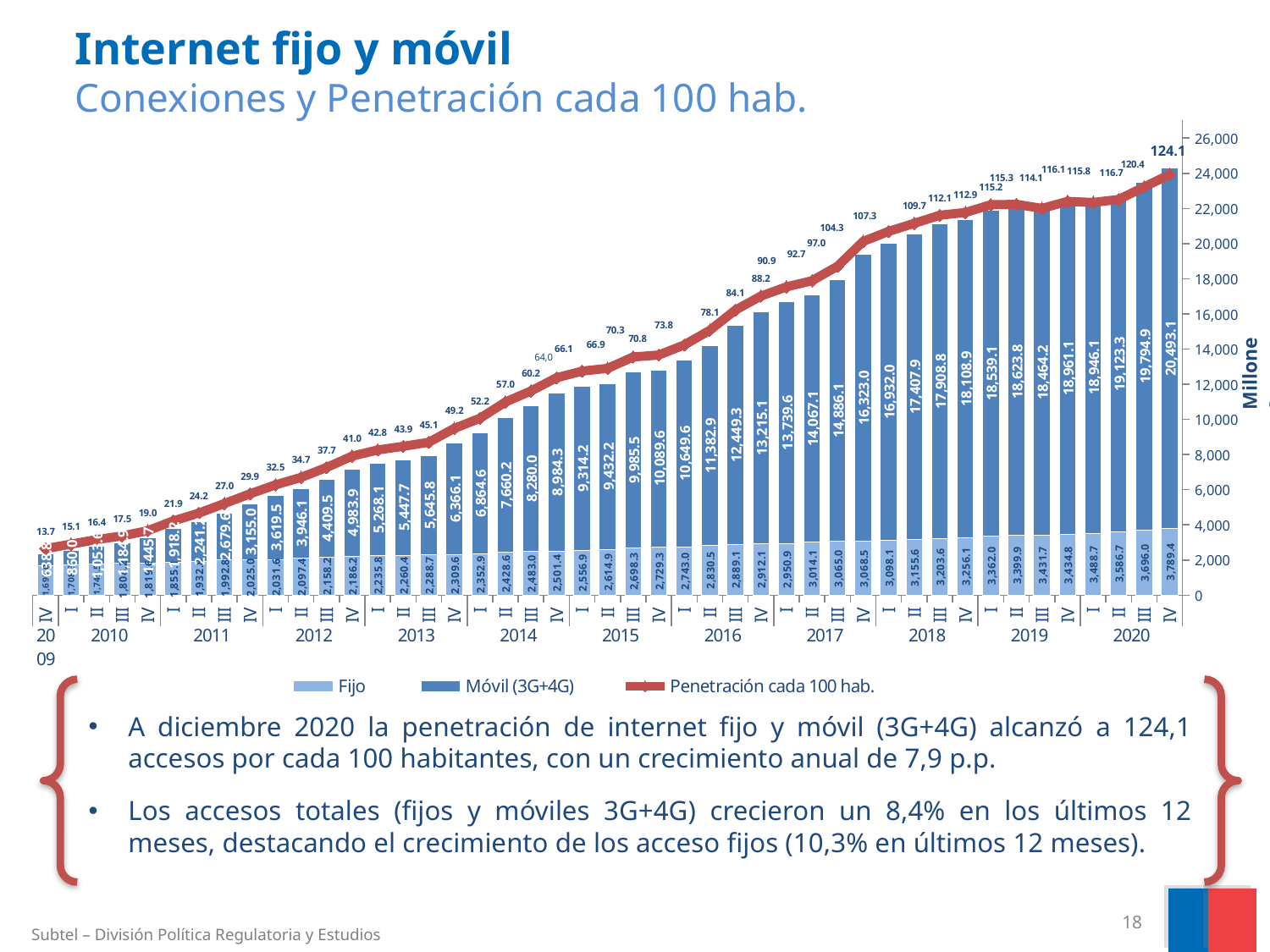
What is the total of the stacked bar (Fijo plus Móvil) for IV 2020? 24,282.5 Which is larger, the Fijo value for IV 2020 or the Fijo value for IV 2019? IV 2020 What is the Fijo value for IV 2020? 3,789.4 What is the Penetración cada 100 hab. value for IV 2009? 13.7 How many series does the legend list? 3 Does the Penetración cada 100 hab. line rise or fall from IV 2009 to IV 2020? rise What is the Penetración cada 100 hab. value for IV 2020? 124.1 What kind of chart is shown on the slide? Stacked bar chart with a line In which quarter is the Penetración cada 100 hab. line highest? IV 2020 What is the difference between the Móvil (3G+4G) values for IV 2020 and III 2020? 698.2 What is the Móvil (3G+4G) value for IV 2017? 16,323.0 What is the Móvil (3G+4G) value for IV 2020? 20,493.1